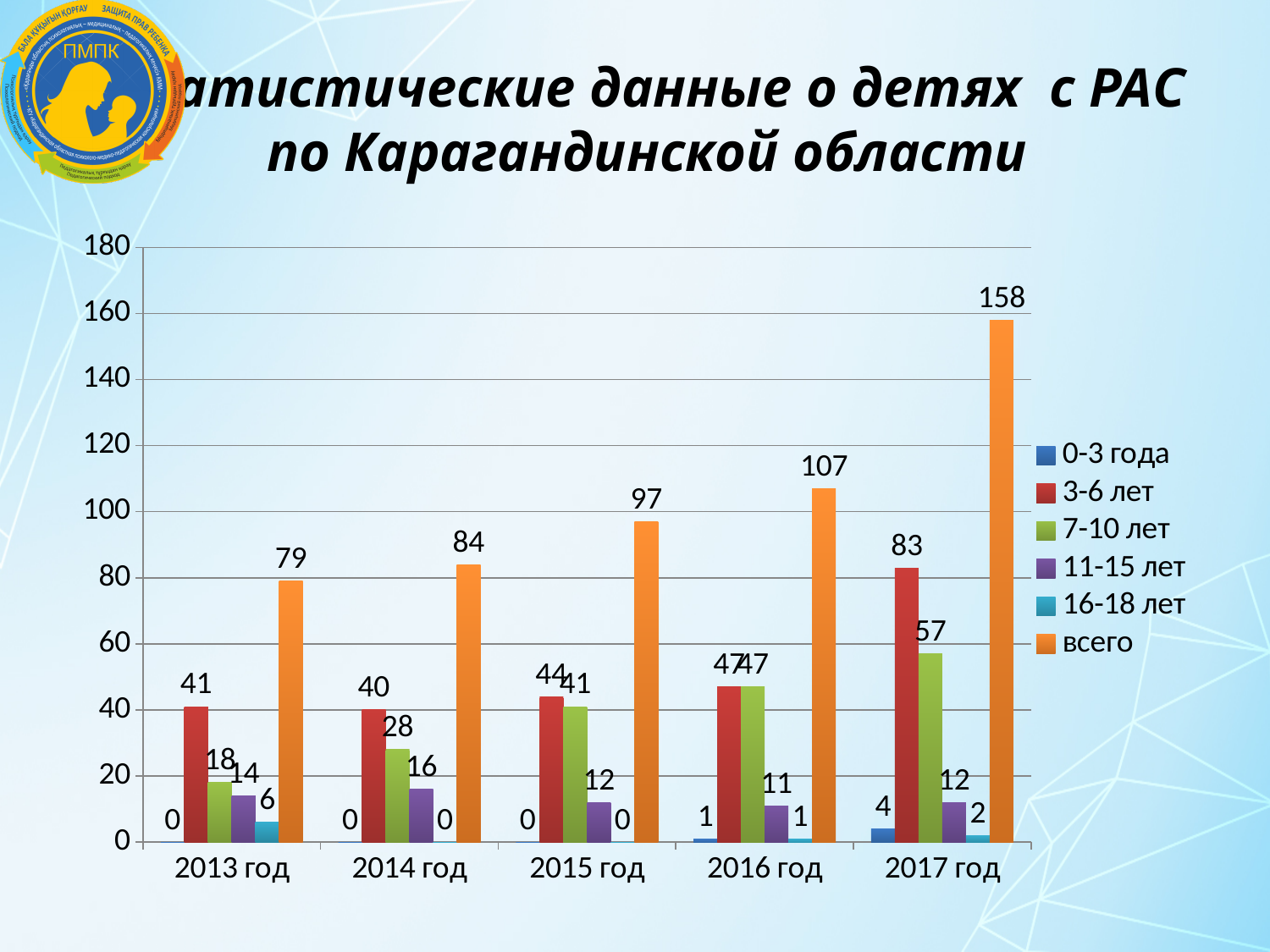
How many years are shown on the x axis? 5 What is the value of "всего" for 2017 год? 158 Does the "всего" value rise or fall from 2013 год to 2017 год? rise How many series does the legend list? 6 What is the value of "3-6 лет" for 2013 год? 41 What kind of chart is shown on the slide? bar chart What is the value of "11-15 лет" for 2016 год? 11 Which year has the lowest value for "всего"? 2013 год What is the value of "7-10 лет" for 2014 год? 28 Which is larger: "3-6 лет" in 2017 год or "7-10 лет" in 2017 год? 3-6 лет in 2017 год Which year has the highest value for "всего"? 2017 год What is the difference between the "всего" values for 2017 год and 2016 год? 51